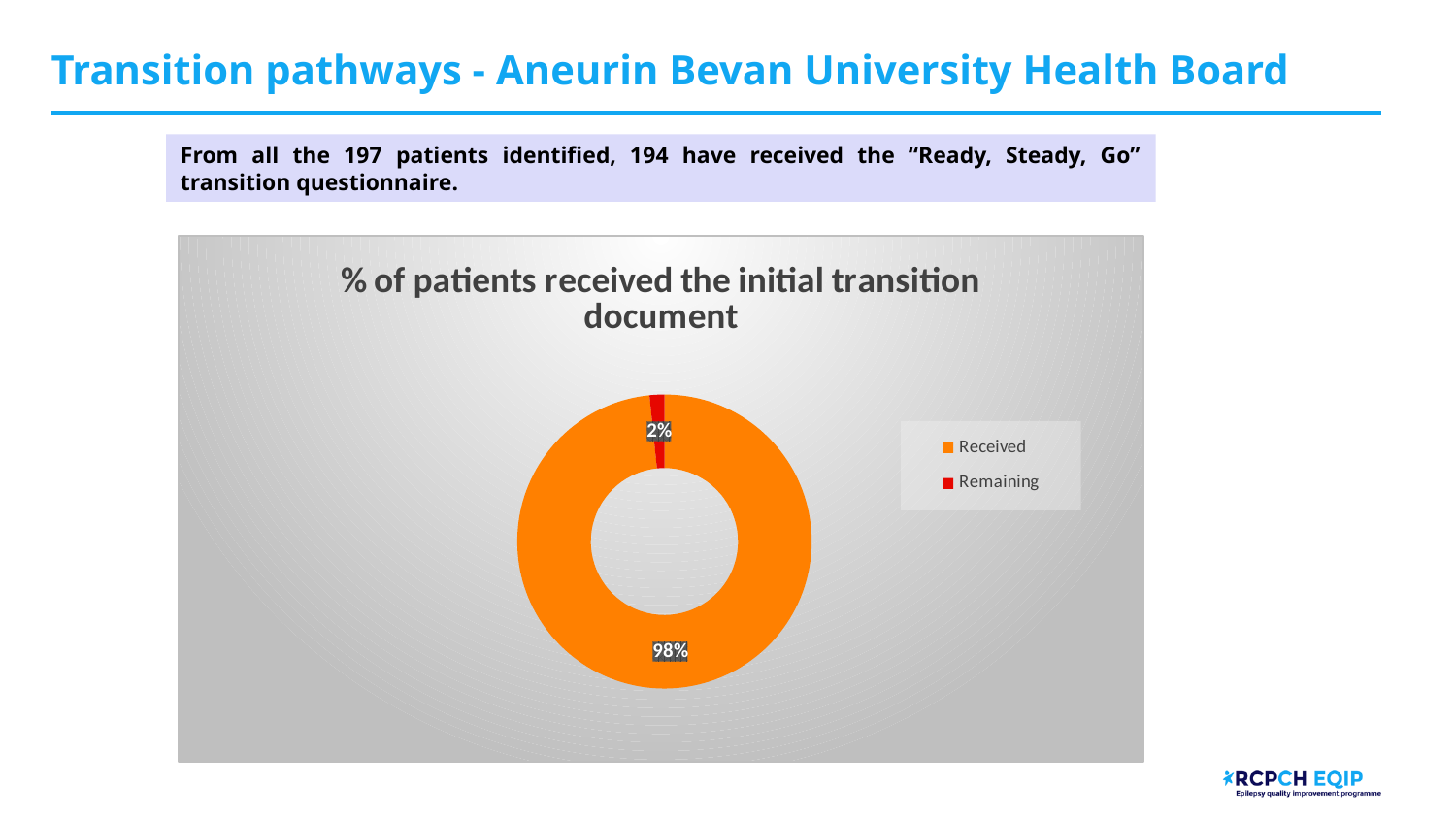
What percentage of patients are shown as 'Received' in the chart? 98% What is the difference in percentage points between the 'Received' and 'Remaining' slices? 96 Which category has the smallest share of the chart? Remaining Which category has the largest share of the chart? Received What is the title of the chart? % of patients received the initial transition document What colour represents the 'Remaining' category in the chart? Red What share of the chart does the 'Received' slice represent? 98% How many entries does the legend list? 2 What percentage of patients are shown as 'Remaining' in the chart? 2% What kind of chart is shown on the slide? Doughnut (pie) chart Which is larger, the 'Received' slice or the 'Remaining' slice? Received How many categories does the chart show? 2